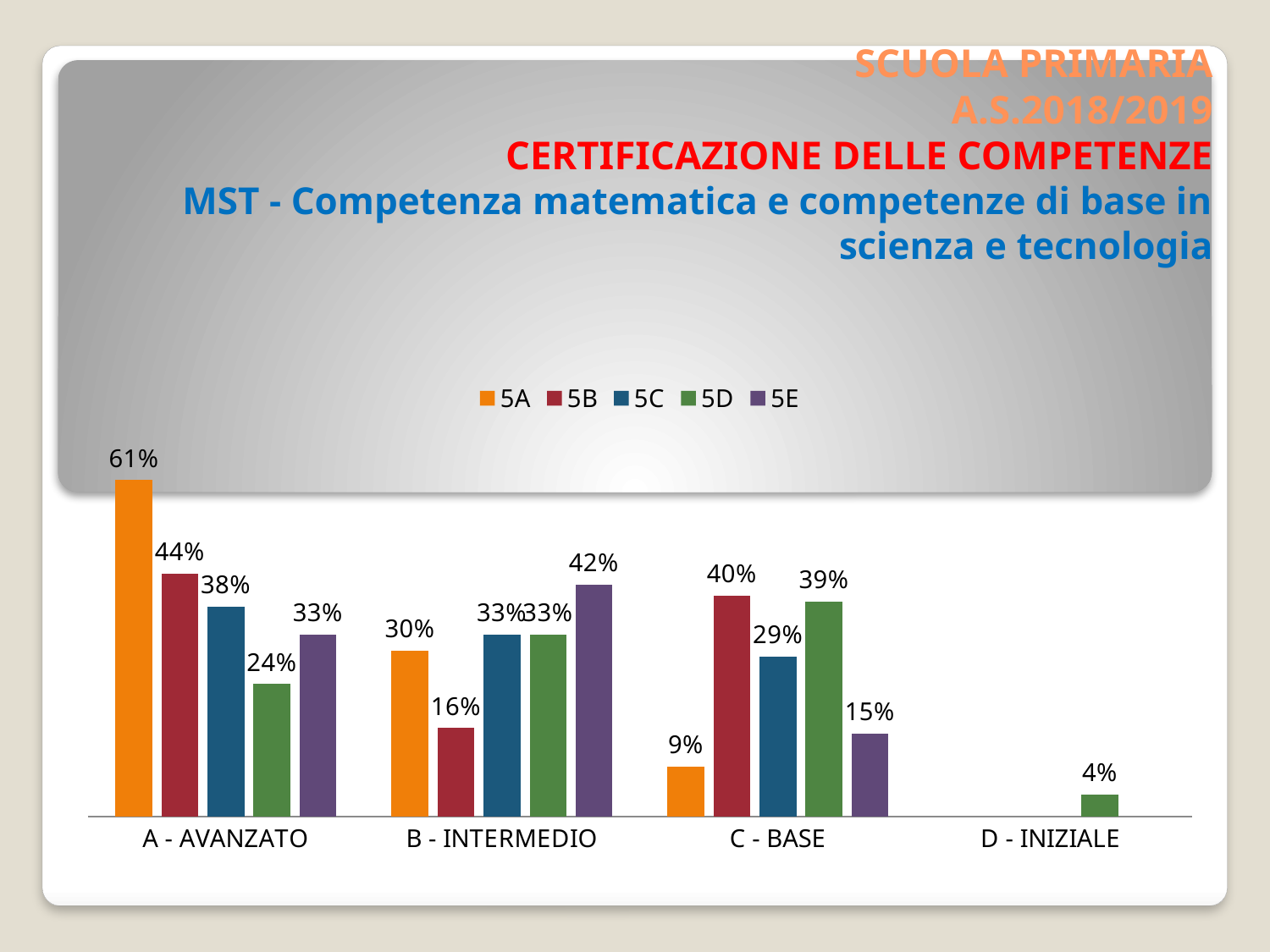
Which class has the lowest value at level A - AVANZATO? 5D What is the difference between the 5A and 5B values at level A - AVANZATO? 17% What kind of chart is shown on the slide? Bar chart What is the value for class 5E at level B - INTERMEDIO? 42% What percentage of class 5A is at level A - AVANZATO? 61% Which class has the highest value at level C - BASE? 5B Which class is the only one with a bar at level D - INIZIALE? 5D What percentage of class 5D is at level D - INIZIALE? 4% What is the difference between the 5B and 5E values at level C - BASE? 25% At level B - INTERMEDIO, which is larger: the value for 5A or the value for 5B? 5A How many classes does the legend list? 5 How many competence levels are shown on the x axis? 4